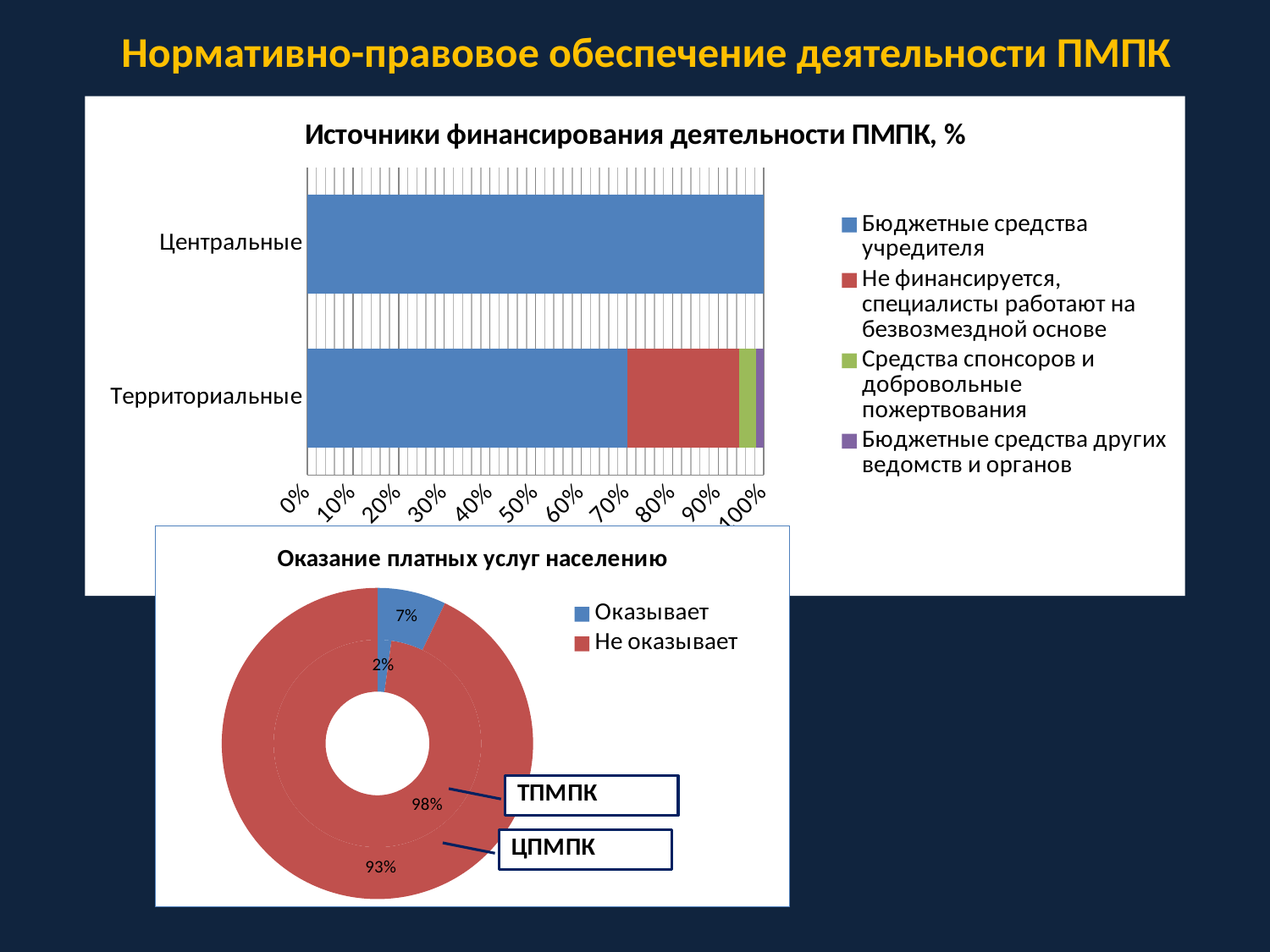
In the chart "Источники финансирования деятельности ПМПК, %", is the value of "Бюджетные средства учредителя" for Территориальные greater or less than 60%? greater How many categories are shown on the y axis of the chart "Источники финансирования деятельности ПМПК, %"? 2 In the chart "Источники финансирования деятельности ПМПК, %", which legend entry is shown in green? Средства спонсоров и добровольные пожертвования In the chart "Источники финансирования деятельности ПМПК, %", which category has the larger share of "Бюджетные средства учредителя": Центральные or Территориальные? Центральные How many series does the legend of the chart "Источники финансирования деятельности ПМПК, %" list? 4 How many entries does the legend of the chart "Оказание платных услуг населению" list? 2 In the chart "Оказание платных услуг населению", what is the share of "Оказывает" for ЦПМПК? 7% What kind of chart is the chart titled "Источники финансирования деятельности ПМПК, %"? bar chart In the chart "Источники финансирования деятельности ПМПК, %", is the value of "Не финансируется, специалисты работают на безвозмездной основе" for Территориальные greater or less than 30%? less In the chart "Оказание платных услуг населению", what is the difference between the "Не оказывает" shares for ТПМПК (98%) and ЦПМПК (93%)? 5% In the chart "Оказание платных услуг населению", what is the share of "Не оказывает" for ТПМПК? 98% What kind of chart is the chart titled "Оказание платных услуг населению"? doughnut chart